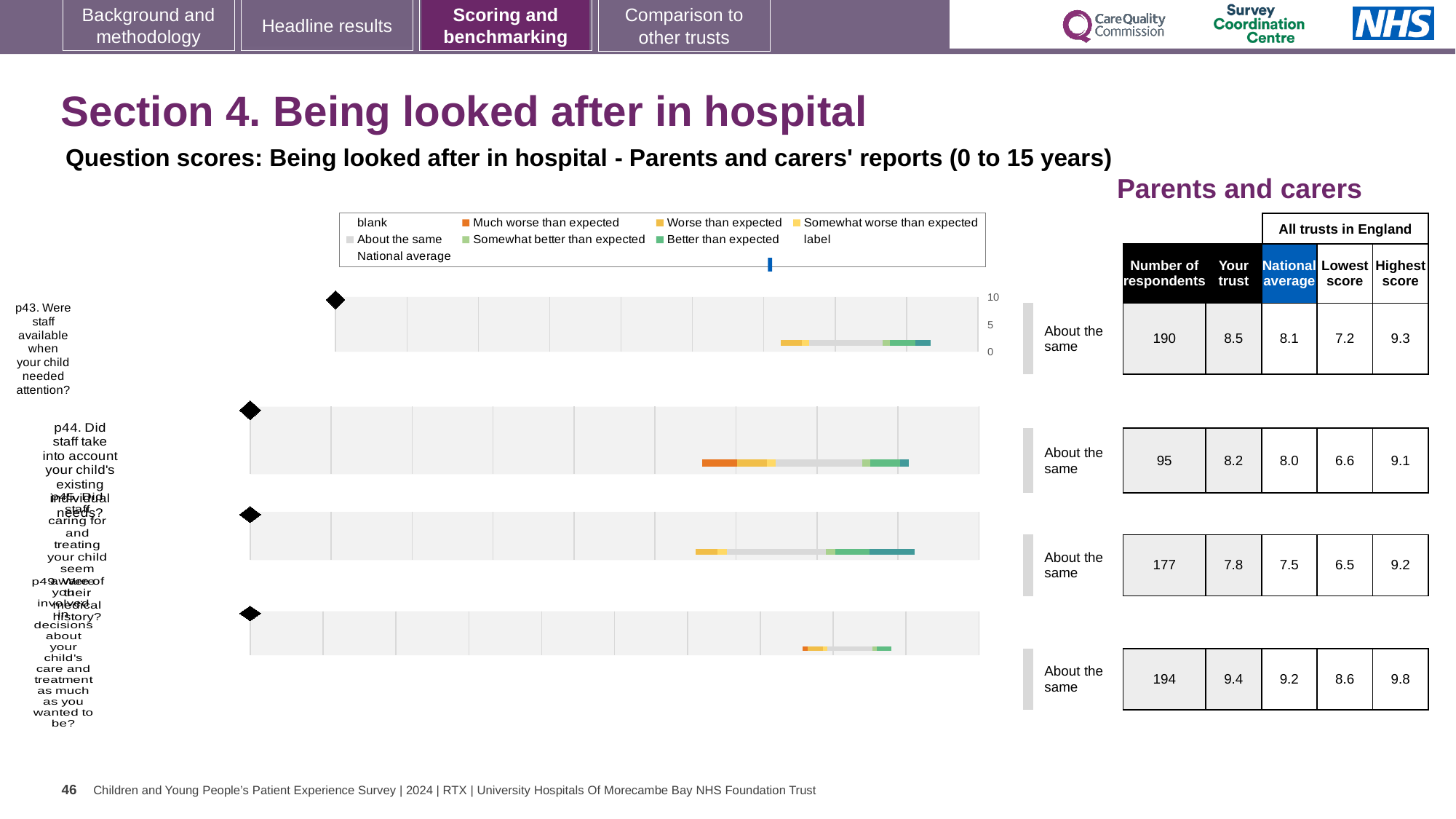
Which question row has the lowest 'Lowest score' value? The third row, 6.5 How many respondents are shown for the first question row (p43)? 190 For the third question row, which is larger: the 'Your trust' score or the national average? Your trust (7.8) What benchmark category is shown for all four question rows? About the same Which question row has the highest 'Your trust' score? The fourth (bottom) row, 9.4 What is the 'Your trust' score for p43 (Were staff available when your child needed attention?)? 8.5 How many question rows (charts) are shown on the slide? 4 For p43, how much higher is the 'Your trust' score than the national average? 0.4 For the fourth question row, what is the difference between the highest score and the lowest score? 1.2 What kind of chart is used for each question row? Bar chart What is the highest score among all trusts in England for the third question row? 9.2 What is the national average for the fourth (bottom) question row? 9.2